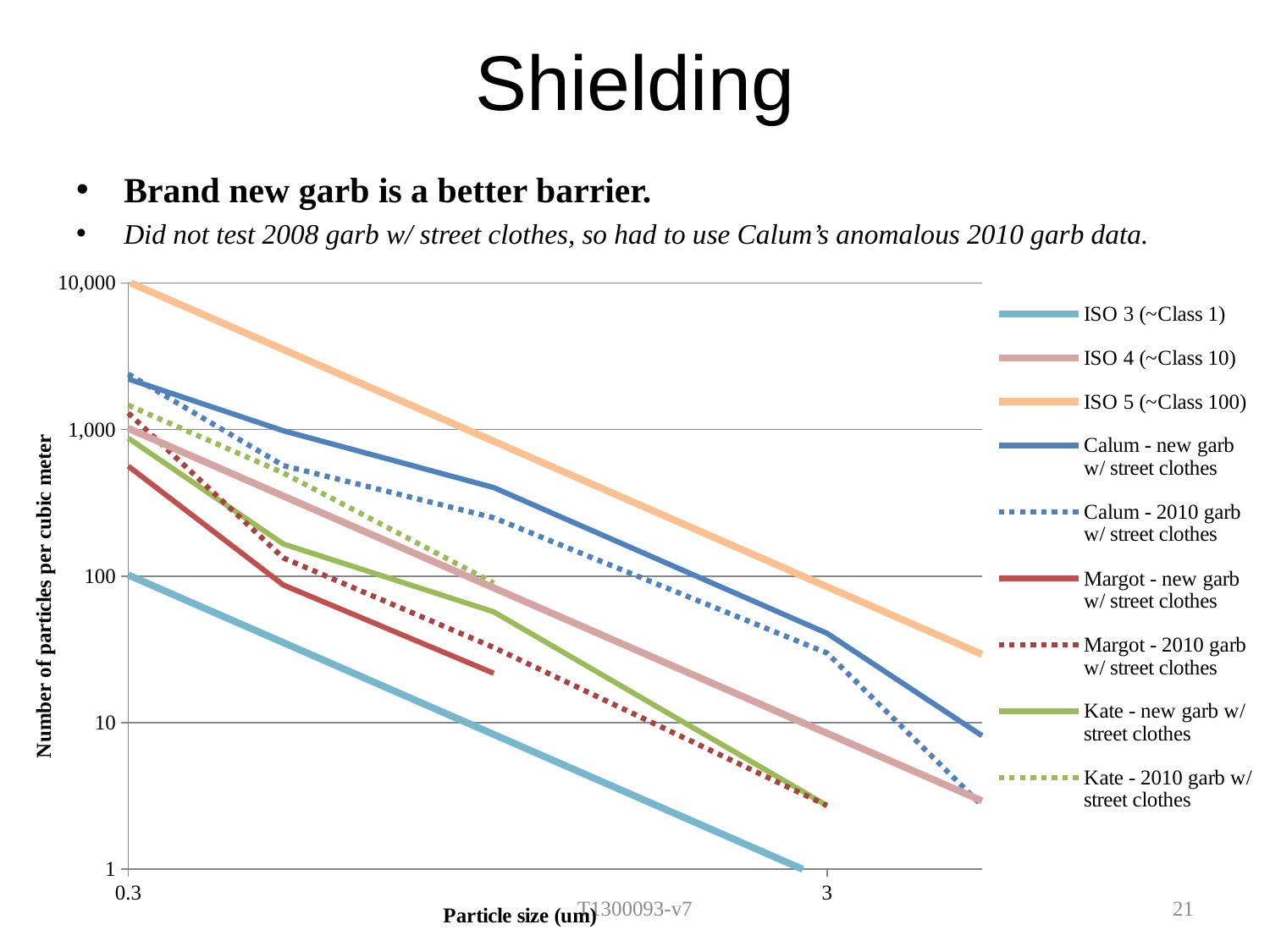
What is the title of the chart's x axis? Particle size (um) What kind of chart is shown on the slide? line chart What is the title of the chart's y axis? Number of particles per cubic meter How many series does the chart legend list? 9 Is the value for Calum - new garb w/ street clothes at 0.3 um greater or less than 1,000? greater At 0.3 um, which is larger: the value for Calum - new garb w/ street clothes or Margot - new garb w/ street clothes? Calum - new garb w/ street clothes Is the value for Margot - new garb w/ street clothes at 0.3 um greater or less than 1,000? less Do the number of particles per cubic meter rise or fall as particle size increases along the x axis? fall Is the value for Kate - new garb w/ street clothes at 0.3 um greater or less than 1,000? less Which series has the lowest number of particles per cubic meter at a particle size of 0.3 um? ISO 3 (~Class 1) Which series has the highest number of particles per cubic meter at a particle size of 0.3 um? ISO 5 (~Class 100)